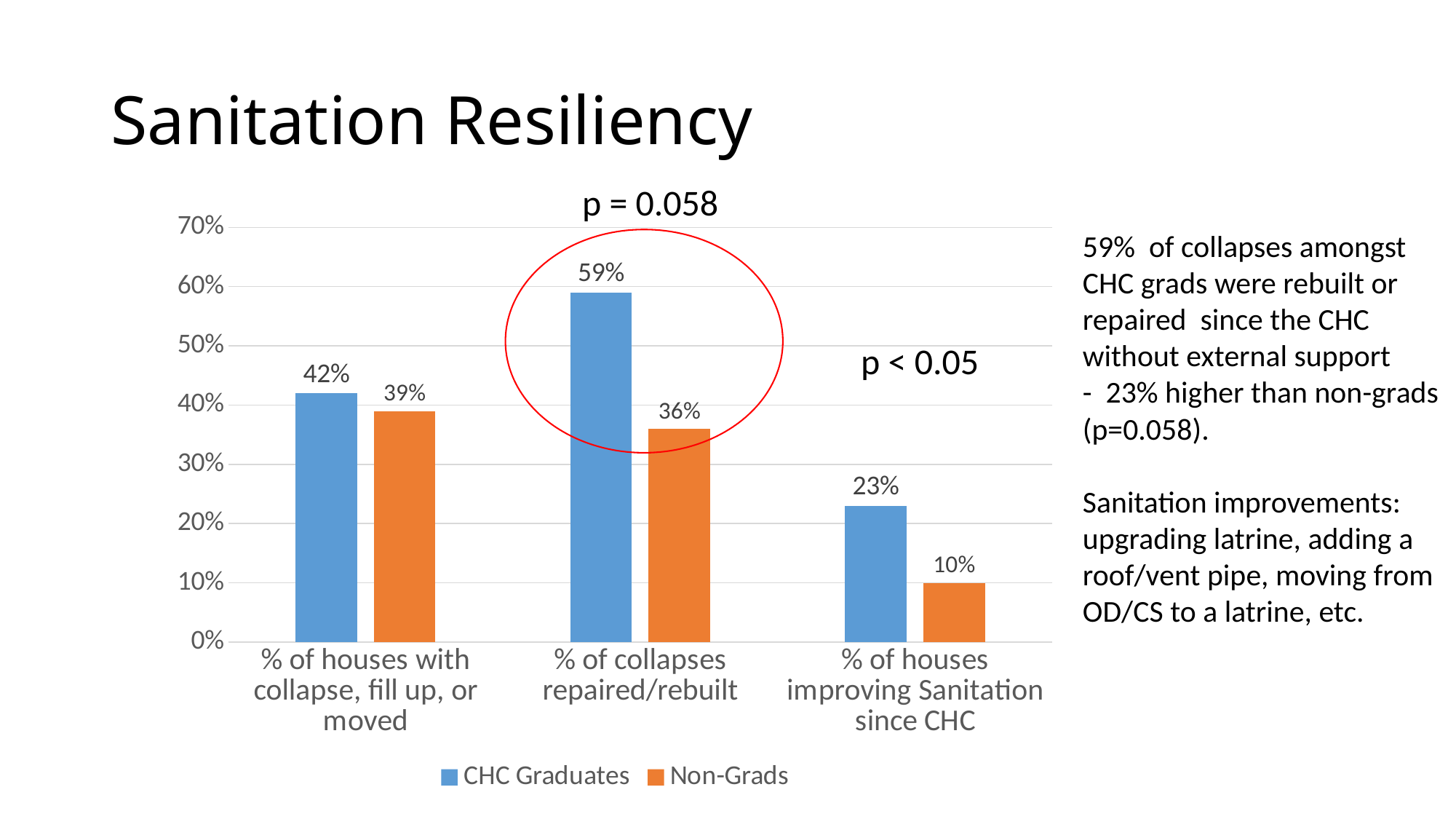
What kind of chart is shown on the slide? Bar chart How many series does the legend list? 2 What colour are the Non-Grads bars? Orange What is the difference between CHC Graduates and Non-Grads in the '% of collapses repaired/rebuilt' category? 23% How many categories are shown on the x axis? 3 In which category is the Non-Grads value lowest? % of houses improving Sanitation since CHC What is the value for Non-Grads in the '% of houses improving Sanitation since CHC' category? 10% In which category is the CHC Graduates value highest? % of collapses repaired/rebuilt Is the value for CHC Graduates in the '% of houses with collapse, fill up, or moved' category greater or less than 40%? greater What is the value for Non-Grads in the '% of houses with collapse, fill up, or moved' category? 39% What is the value for CHC Graduates in the '% of collapses repaired/rebuilt' category? 59% Which series has the larger value in the '% of houses improving Sanitation since CHC' category? CHC Graduates